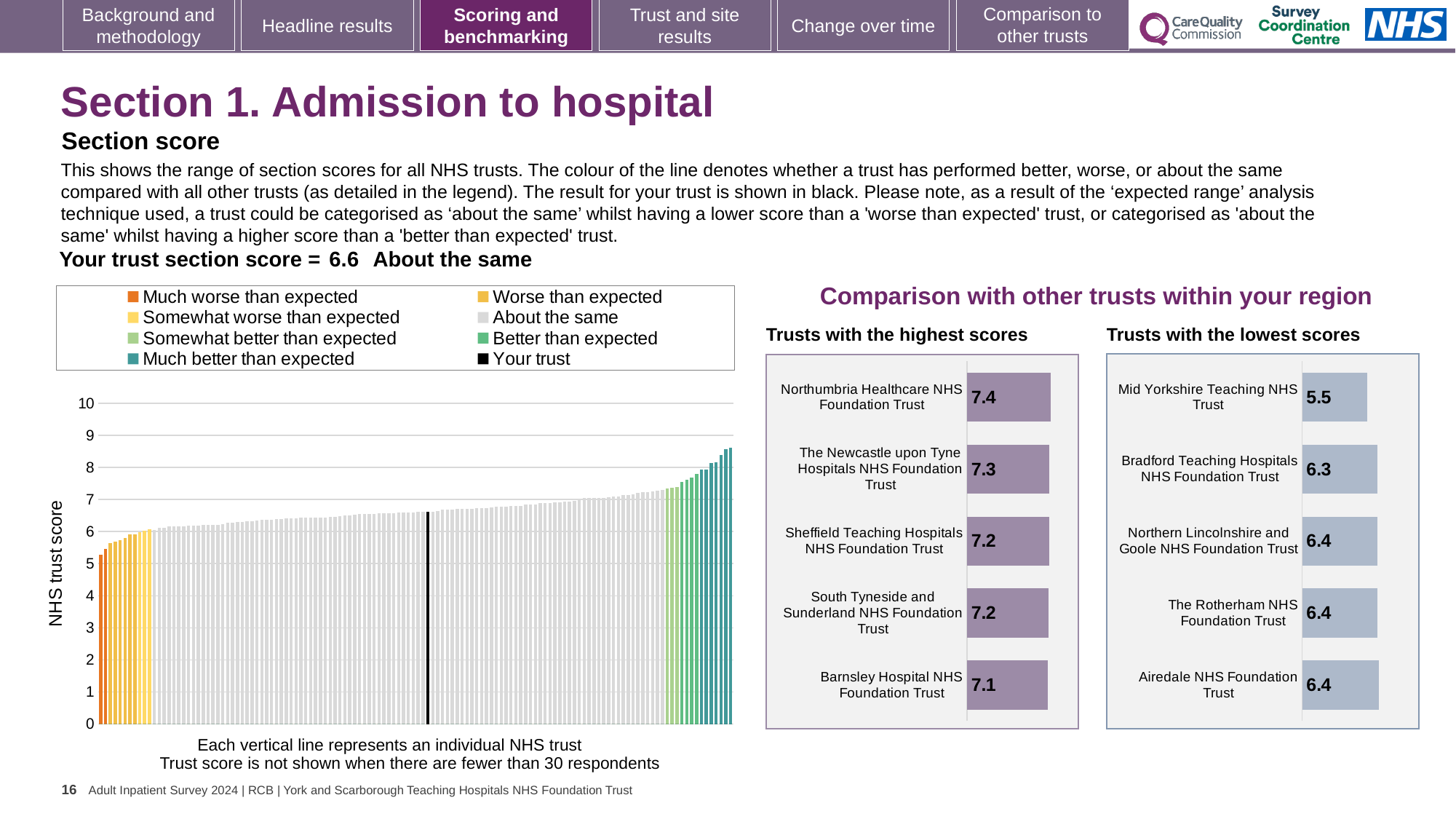
In the 'Trusts with the lowest scores' chart, how many trusts are listed? 5 In the 'Trusts with the lowest scores' chart, what is the difference between the scores of Bradford Teaching Hospitals NHS Foundation Trust and Mid Yorkshire Teaching NHS Trust? 0.8 In the large chart on the left, do the NHS trust scores rise or fall from left to right? Rise In the 'Trusts with the highest scores' chart, what is the score for Northumbria Healthcare NHS Foundation Trust? 7.4 What kind of chart is the large chart on the left showing NHS trust scores? Bar chart How many entries does the legend of the large chart on the left list? 8 In the 'Trusts with the highest scores' chart, which trust has the highest score? Northumbria Healthcare NHS Foundation Trust In the 'Trusts with the highest scores' chart, what is the difference between the scores of Northumbria Healthcare NHS Foundation Trust and Barnsley Hospital NHS Foundation Trust? 0.3 In the 'Trusts with the highest scores' chart, what is the score for Barnsley Hospital NHS Foundation Trust? 7.1 In the 'Trusts with the lowest scores' chart, which trust has the lowest score? Mid Yorkshire Teaching NHS Trust In the 'Trusts with the lowest scores' chart, what is the score for Mid Yorkshire Teaching NHS Trust? 5.5 In the large chart on the left, is the value of the black bar (your trust) greater or less than 7? less